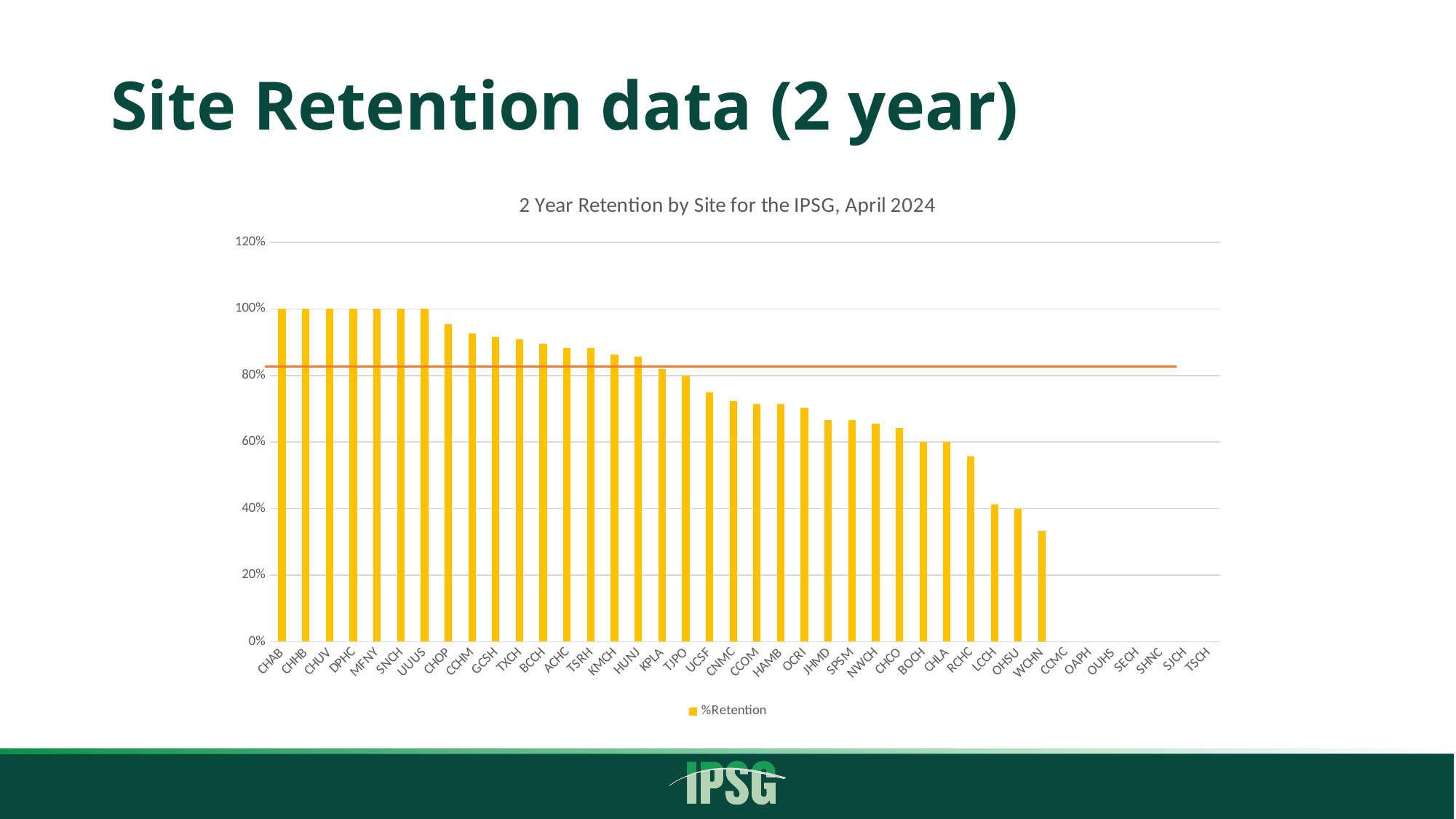
Is the value for JHMD greater or less than 60%? greater What is the title of the chart? 2 Year Retention by Site for the IPSG, April 2024 What is the name of the series shown in the legend? %Retention What kind of chart is shown on the slide? bar chart Is the value for CHOP greater or less than 80%? greater Is the value for WCHN greater or less than 40%? less What is the retention value for CHAB? 100% Which has a higher retention value, CHOP or UCSF? CHOP Do the retention values rise or fall moving from left to right along the x axis? fall What is the retention value for UUUS? 100% How many series does the legend list? 1